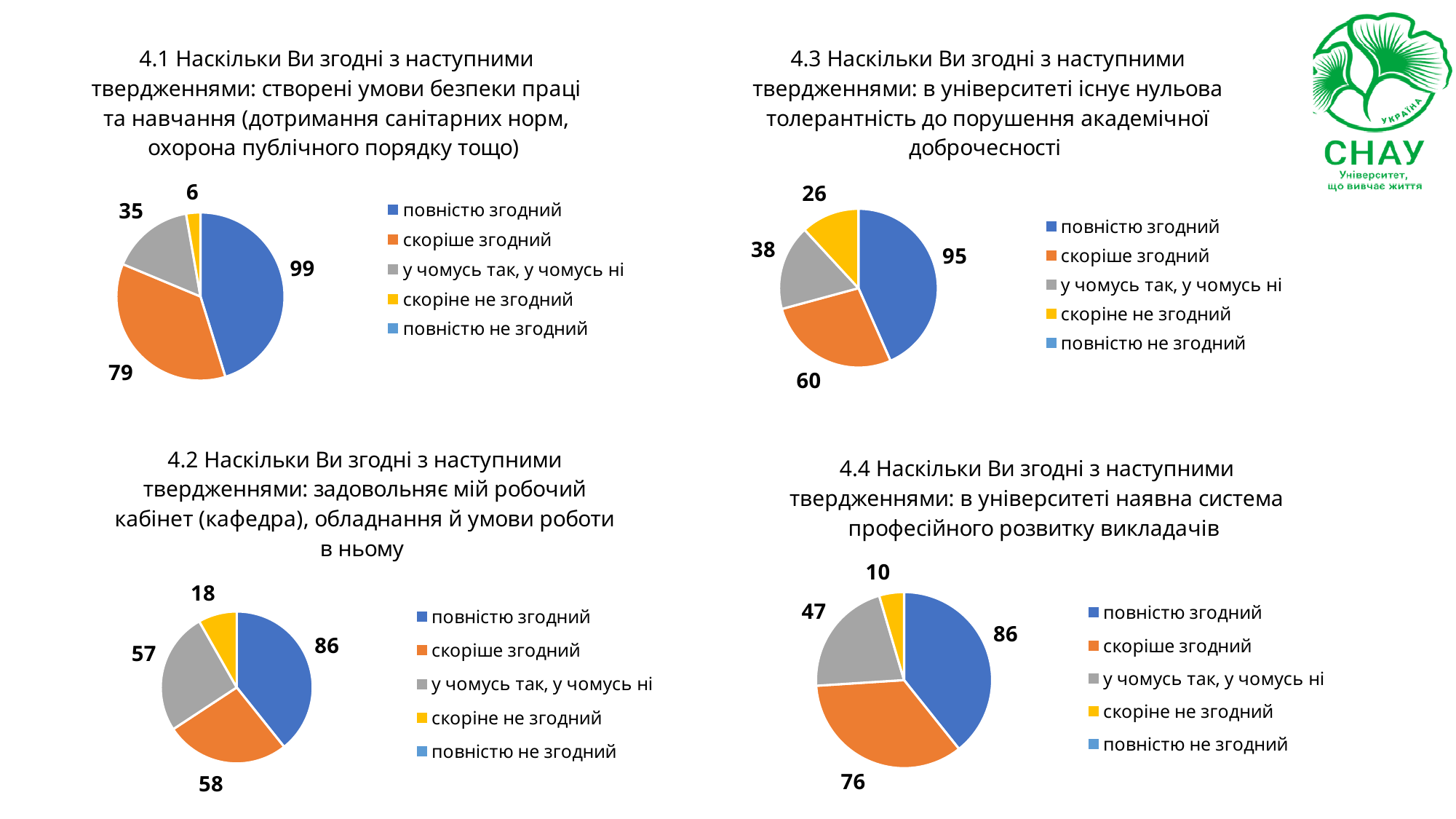
In the chart titled 4.2 (bottom left), which category has the highest value? повністю згодний In the chart titled 4.4 (bottom right), which is larger: "скоріше згодний" or "у чомусь так, у чомусь ні"? скоріше згодний In the chart titled 4.1 (top left), what is the value for "повністю згодний"? 99 In the chart titled 4.2 (bottom left), how many slices have a data label? 4 What type of chart is used for 4.1 (top left)? pie chart In the chart titled 4.3 (top right), what is the value for "скоріне не згодний"? 26 In the chart titled 4.4 (bottom right), which labelled category has the lowest value? скоріне не згодний In the chart titled 4.1 (top left), what is the difference between "повністю згодний" and "скоріше згодний"? 20 In the chart titled 4.3 (top right), what is the value for "скоріше згодний"? 60 In the chart titled 4.1 (top left), what colour is the slice for "повністю згодний"? blue In the chart titled 4.4 (bottom right), what is the difference between "повністю згодний" and "скоріше згодний"? 10 How many entries does the legend of the chart titled 4.3 (top right) list? 5